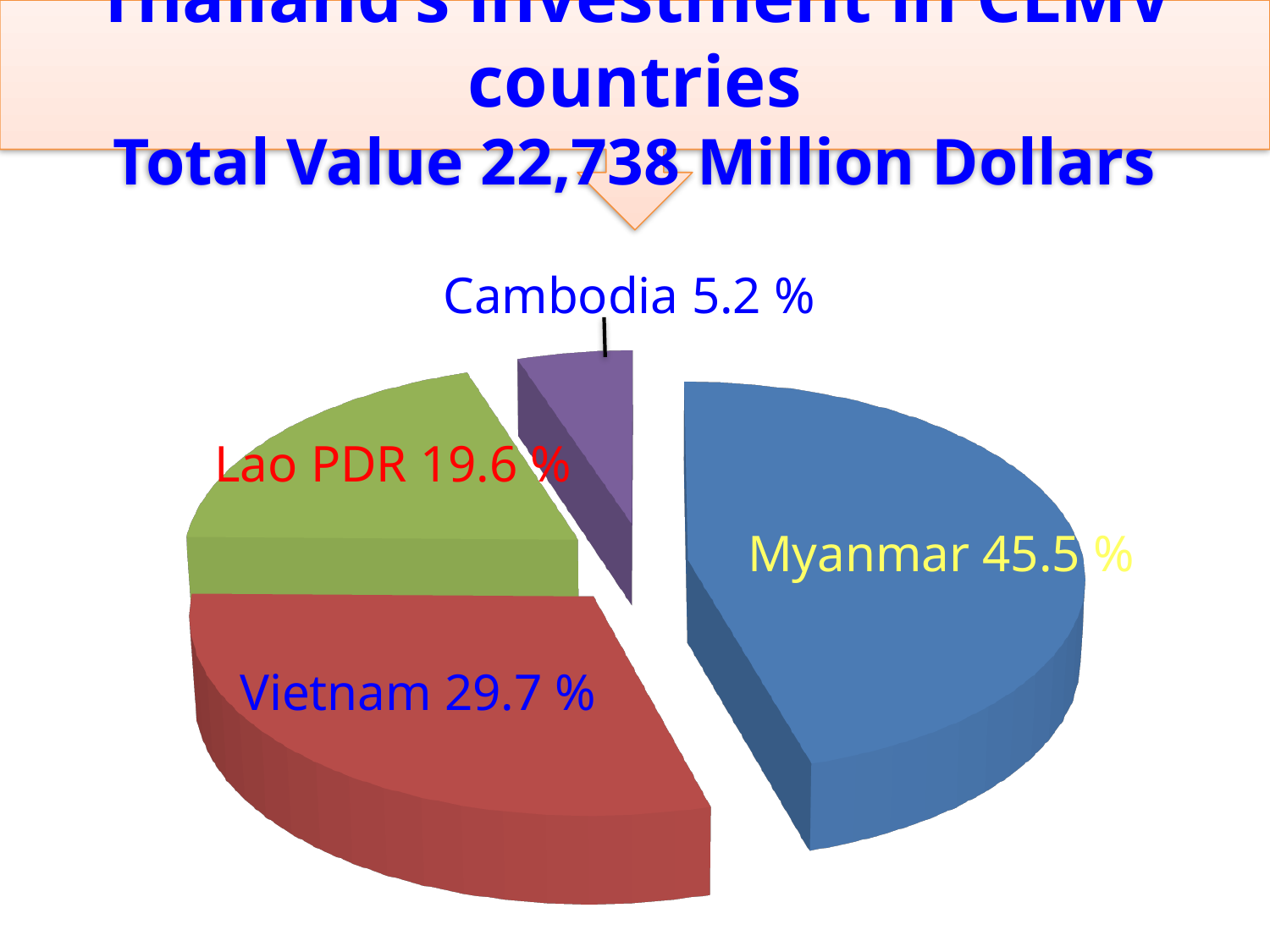
What is the difference in percentage points between Lao PDR's share and Cambodia's share? 14.4 What kind of chart is shown on the slide? Pie chart What is the difference in percentage points between Myanmar's share and Vietnam's share? 15.8 What percentage is shown for Lao PDR? 19.6 % How many countries (slices) are shown in the pie chart? 4 Which country has the smallest slice of the pie? Cambodia What share of the pie does Vietnam account for? 29.7 % Which has a larger share, Vietnam or Lao PDR? Vietnam Which country has the largest slice of the pie? Myanmar What percentage is shown for Cambodia? 5.2 % What total value of investment is stated in the chart title? 22,738 Million Dollars What share of Thailand's investment in CLMV countries goes to Myanmar? 45.5 %